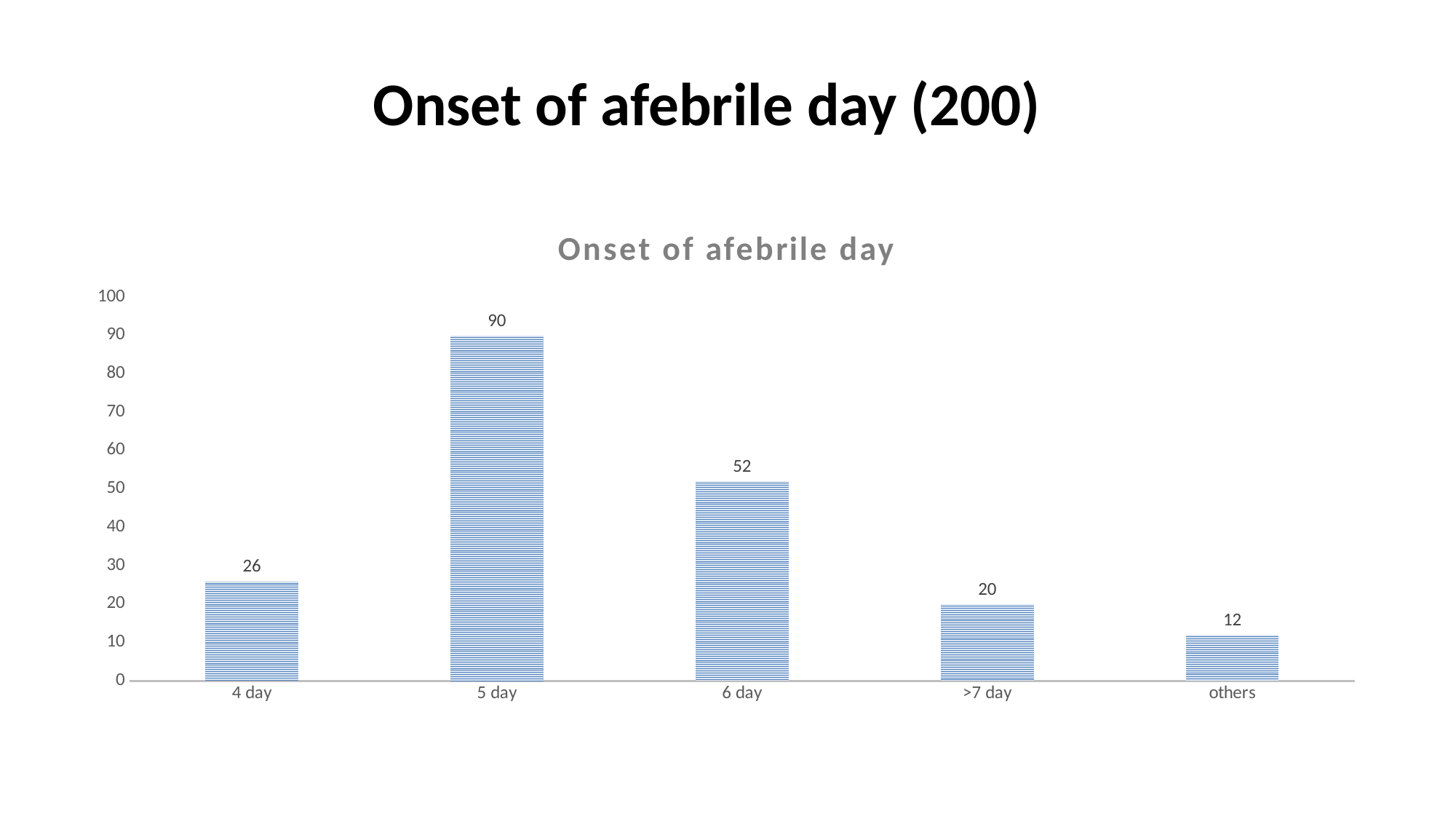
How many categories are shown on the x axis? 5 Is the value for 6 day greater or less than 50? greater Which is larger, the value for 4 day or the value for >7 day? 4 day What is the difference between the values for 4 day and >7 day? 6 What is the difference between the values for 5 day and 6 day? 38 Which category has the highest value? 5 day What is the value for others? 12 What is the title of the chart? Onset of afebrile day Which category has the lowest value? others What is the value for 6 day? 52 What kind of chart is shown on the slide? bar chart What is the value for 5 day? 90